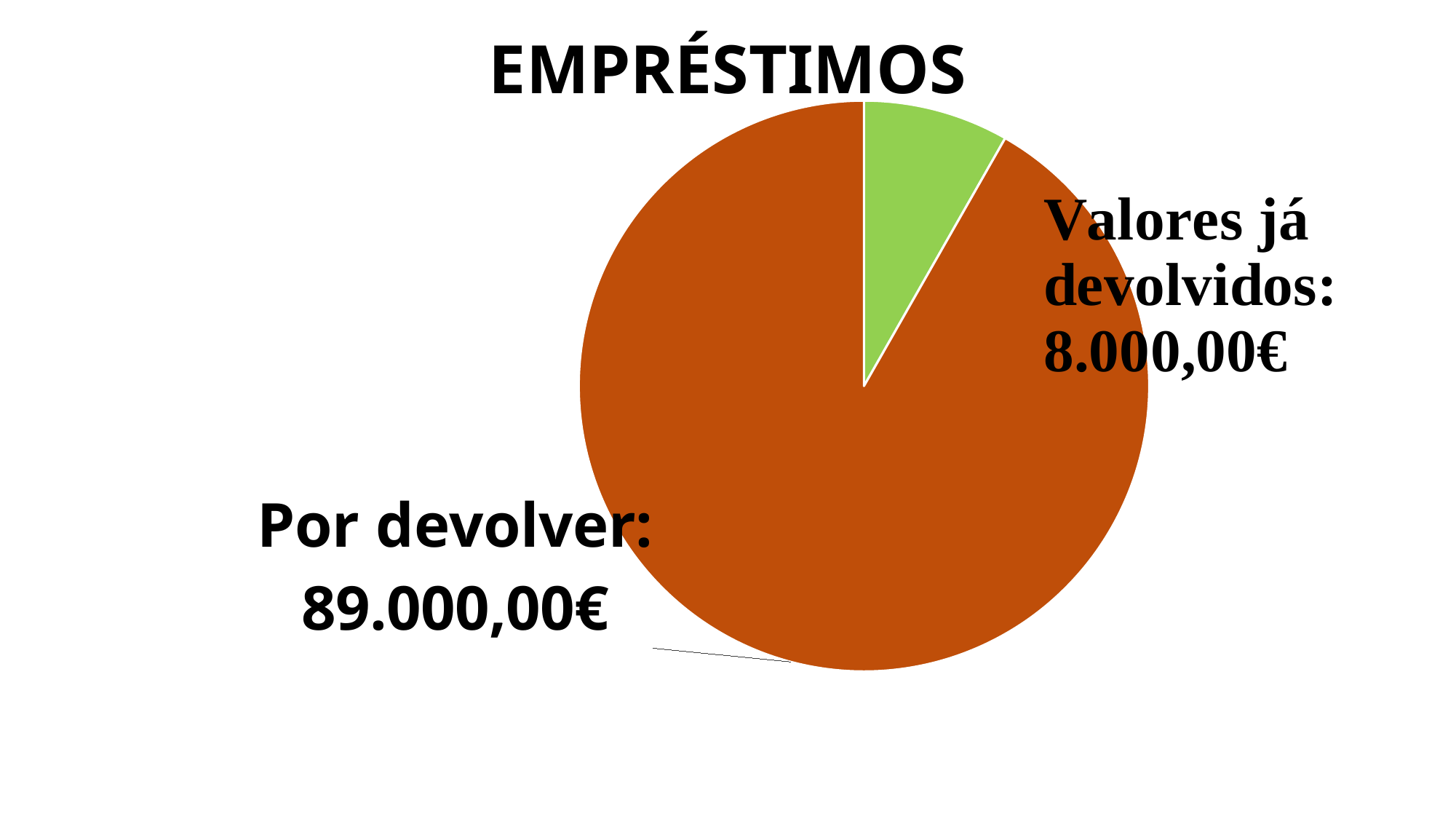
What is the value for "Valores já devolvidos"? 8.000,00€ What type of chart is shown on the slide? pie chart What is the title of the chart? EMPRÉSTIMOS How many slices does the pie chart have? 2 What colour is the "Valores já devolvidos" slice? green What is the value for "Por devolver"? 89.000,00€ What is the total of the two slices in the pie chart? 97.000,00€ What is the difference between the amount "Por devolver" and the "Valores já devolvidos"? 81.000,00€ Which slice is the largest? Por devolver Which slice is the smallest? Valores já devolvidos Which is larger, the amount "Por devolver" or the "Valores já devolvidos"? Por devolver